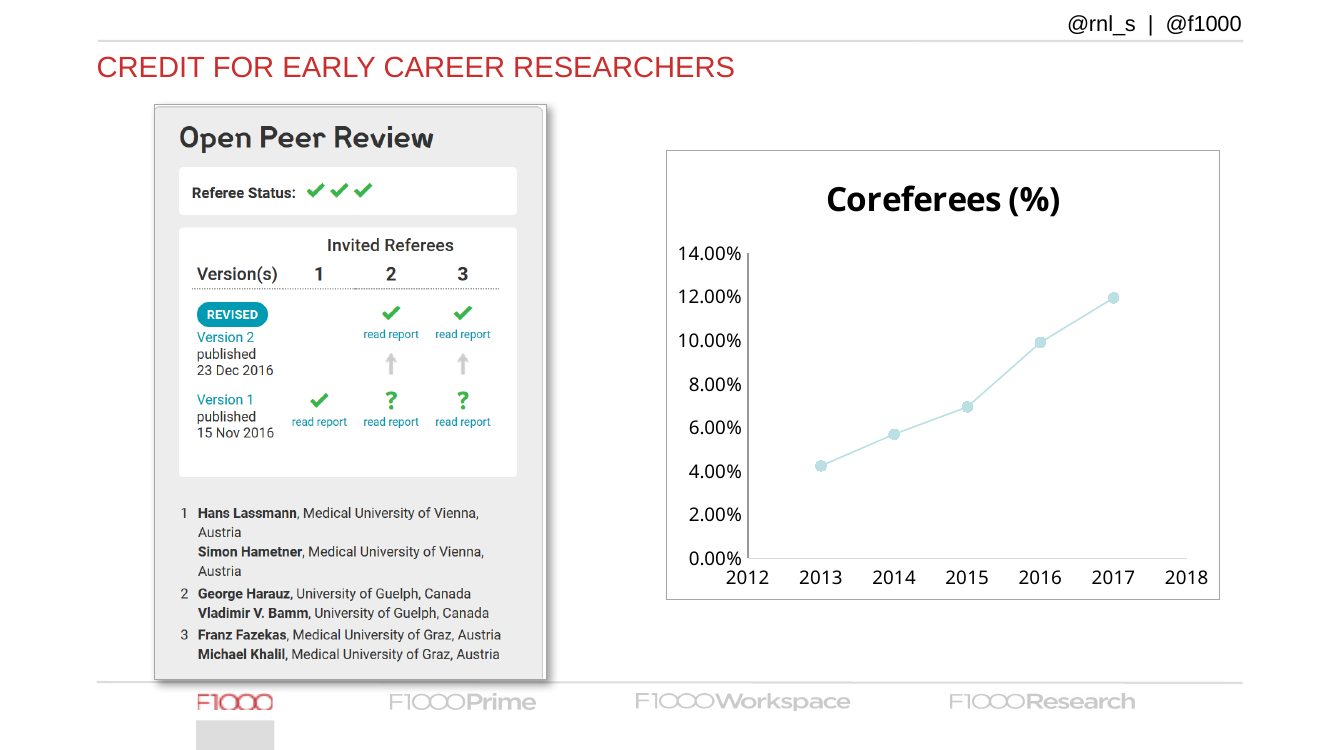
Is the value for 2016 greater or less than 8.00%? greater How many data points are plotted on the Coreferees (%) chart? 5 Is the value for 2017 greater or less than 10.00%? greater Do the values on the Coreferees (%) chart rise or fall from 2013 to 2017? rise Is the value for 2015 greater or less than 8.00%? less Which year has the larger value, 2015 or 2013? 2015 What is the title of the chart? Coreferees (%) Which year has the lowest value on the Coreferees (%) chart? 2013 What kind of chart is shown on the slide? line chart Which year has the highest value on the Coreferees (%) chart? 2017 Which year has the larger value, 2014 or 2016? 2016